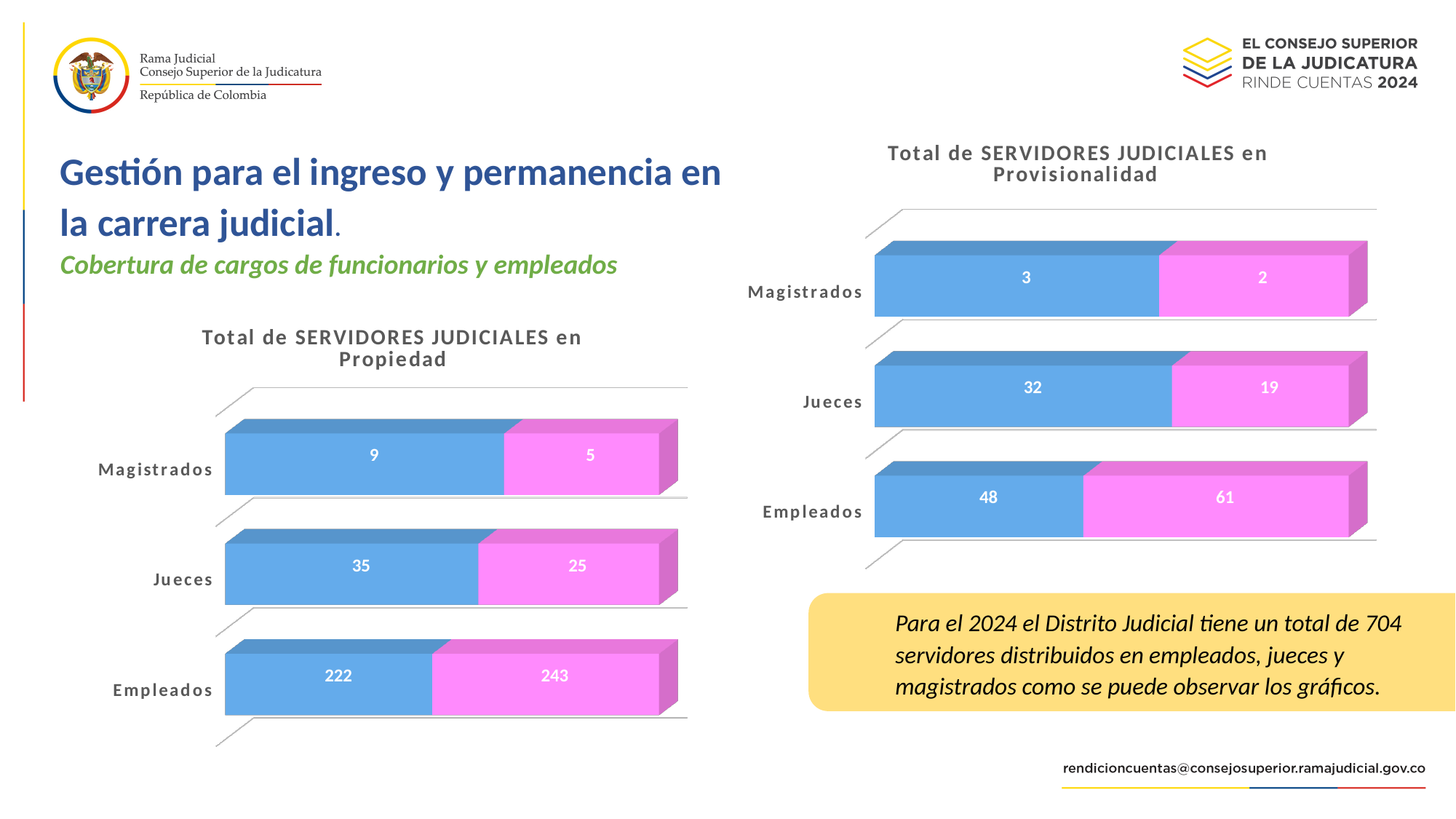
In the 'Total de SERVIDORES JUDICIALES en Propiedad' chart, what is the value of the pink segment for Empleados? 243 In the 'Total de SERVIDORES JUDICIALES en Provisionalidad' chart, what is the value of the pink segment for Empleados? 61 In the 'Total de SERVIDORES JUDICIALES en Provisionalidad' chart, what is the value of the blue segment for Jueces? 32 In the 'Total de SERVIDORES JUDICIALES en Provisionalidad' chart, which is larger for Empleados, the blue segment or the pink segment? the pink segment In the 'Total de SERVIDORES JUDICIALES en Propiedad' chart, what is the difference between the pink and blue segments for Empleados? 21 How many categories are shown in the 'Total de SERVIDORES JUDICIALES en Provisionalidad' chart? 3 In the 'Total de SERVIDORES JUDICIALES en Provisionalidad' chart, what is the total of the two segments for Empleados? 109 In the 'Total de SERVIDORES JUDICIALES en Propiedad' chart, which category has the highest combined total? Empleados In the 'Total de SERVIDORES JUDICIALES en Provisionalidad' chart, what is the difference between the blue and pink segments for Jueces? 13 In the 'Total de SERVIDORES JUDICIALES en Propiedad' chart, what is the value of the blue segment for Magistrados? 9 In the 'Total de SERVIDORES JUDICIALES en Propiedad' chart, what is the total of the two segments for Jueces? 60 What type of chart is the 'Total de SERVIDORES JUDICIALES en Propiedad' chart? stacked bar chart